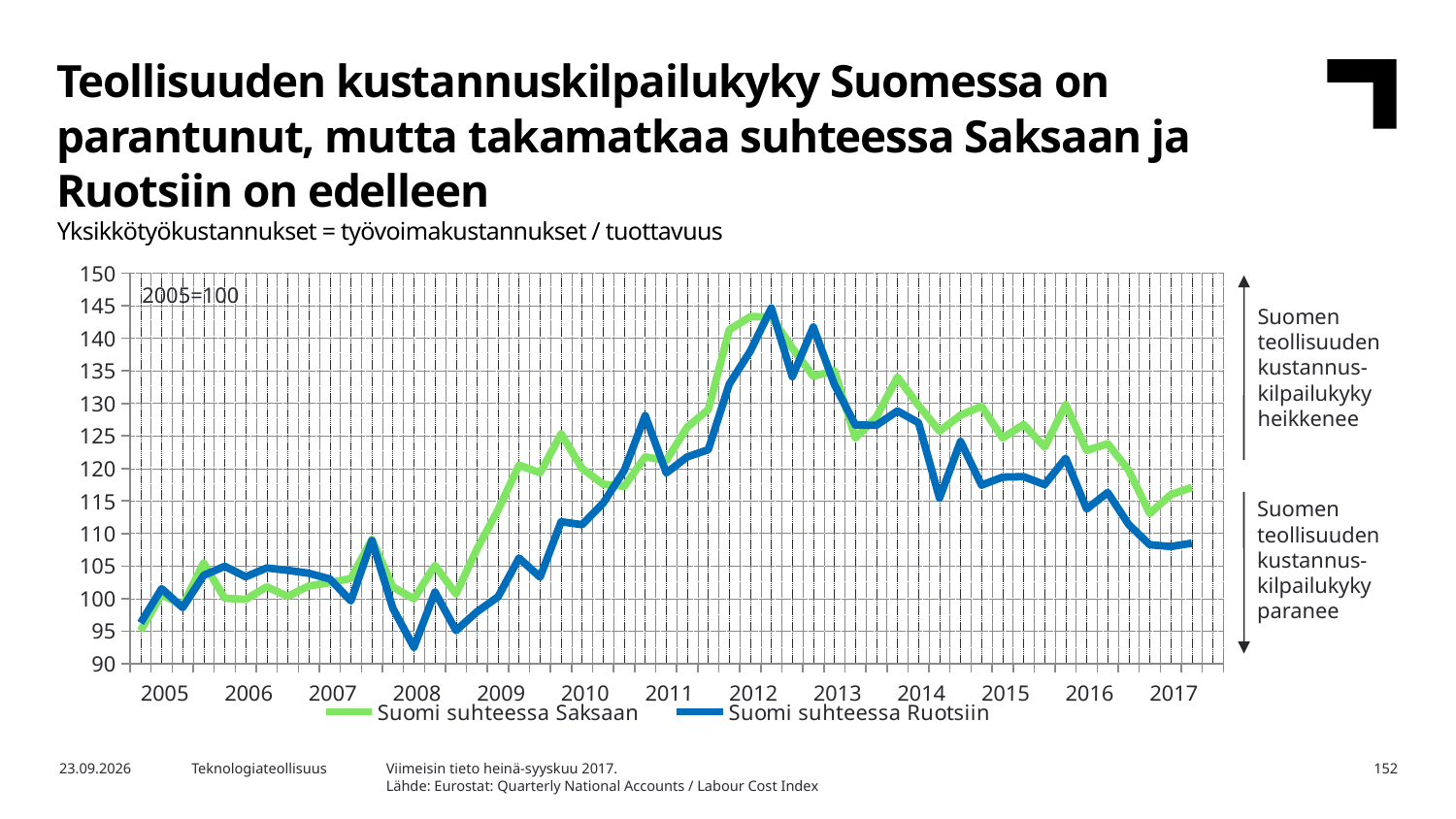
Is the lowest value of Suomi suhteessa Ruotsiin in 2008 greater or less than 95? less At the end of 2017, which series is higher: Suomi suhteessa Saksaan or Suomi suhteessa Ruotsiin? Suomi suhteessa Saksaan What are the two series named in the legend? Suomi suhteessa Saksaan; Suomi suhteessa Ruotsiin Is the last value of Suomi suhteessa Ruotsiin in 2017 greater or less than 110? less How many years are labelled on the x axis? 13 What kind of chart is shown on the slide? line chart How many series does the legend list? 2 Is the peak value of Suomi suhteessa Saksaan around 2012 greater or less than 140? greater Do the values of Suomi suhteessa Ruotsiin rise or fall from 2012 to 2017? fall Do the values of Suomi suhteessa Saksaan rise or fall from 2008 to 2012? rise What base year and value does the note inside the chart give for the index? 2005=100